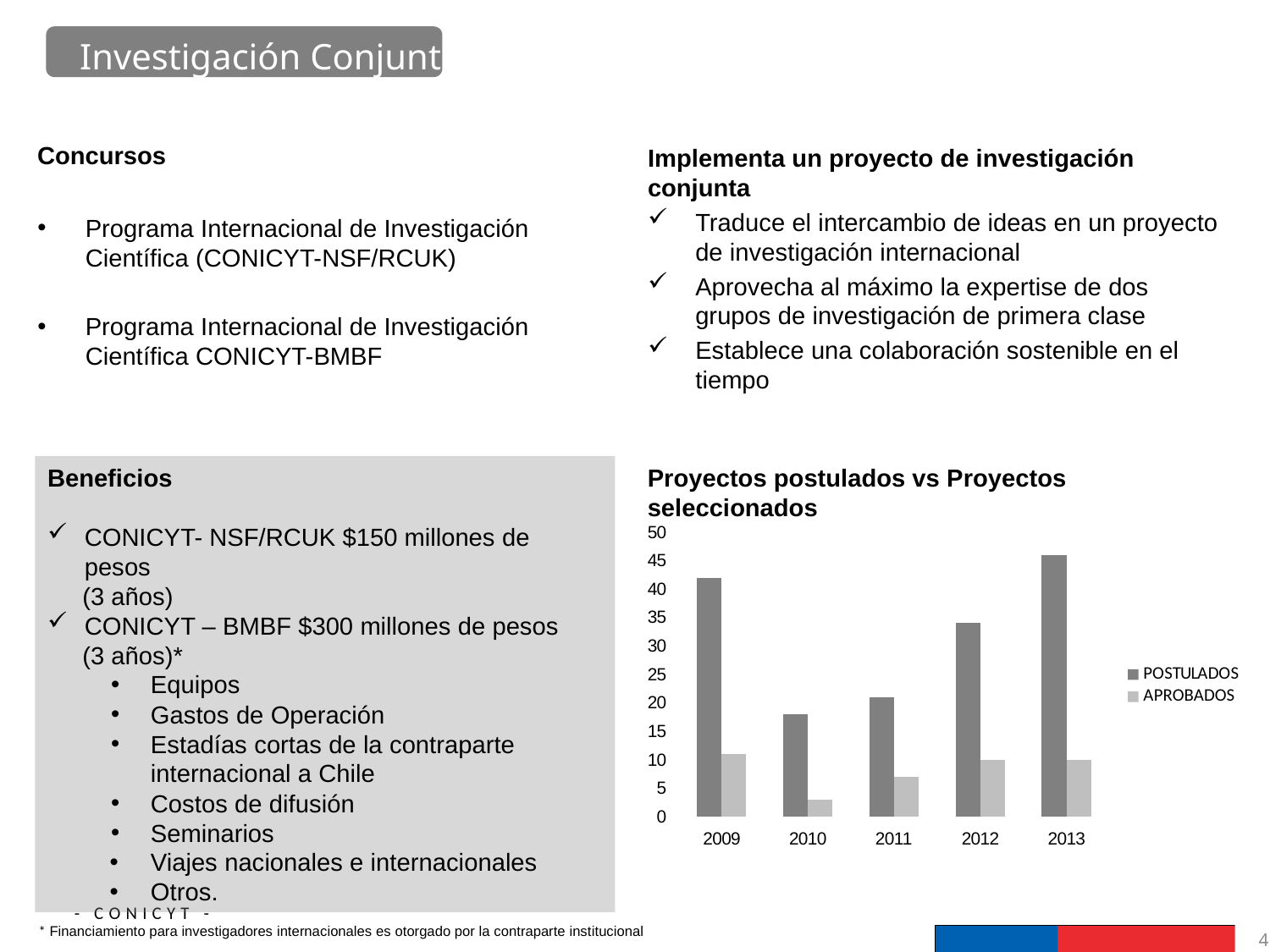
Is the POSTULADOS value for 2010 greater or less than 20? less Which is larger in the chart: POSTULADOS for 2012 or POSTULADOS for 2011? POSTULADOS for 2012 Which year has the lowest POSTULADOS value in the chart? 2010 How many series does the legend of the chart list? 2 Is the POSTULADOS value for 2009 greater or less than 40? greater Which year has the lowest APROBADOS value in the chart? 2010 What are the two legend entries of the chart? POSTULADOS and APROBADOS How many years are shown on the x axis of the chart? 5 What kind of chart is shown under the title 'Proyectos postulados vs Proyectos seleccionados'? bar chart Is the APROBADOS value for 2010 greater or less than 5? less Which year has the highest POSTULADOS value in the chart? 2013